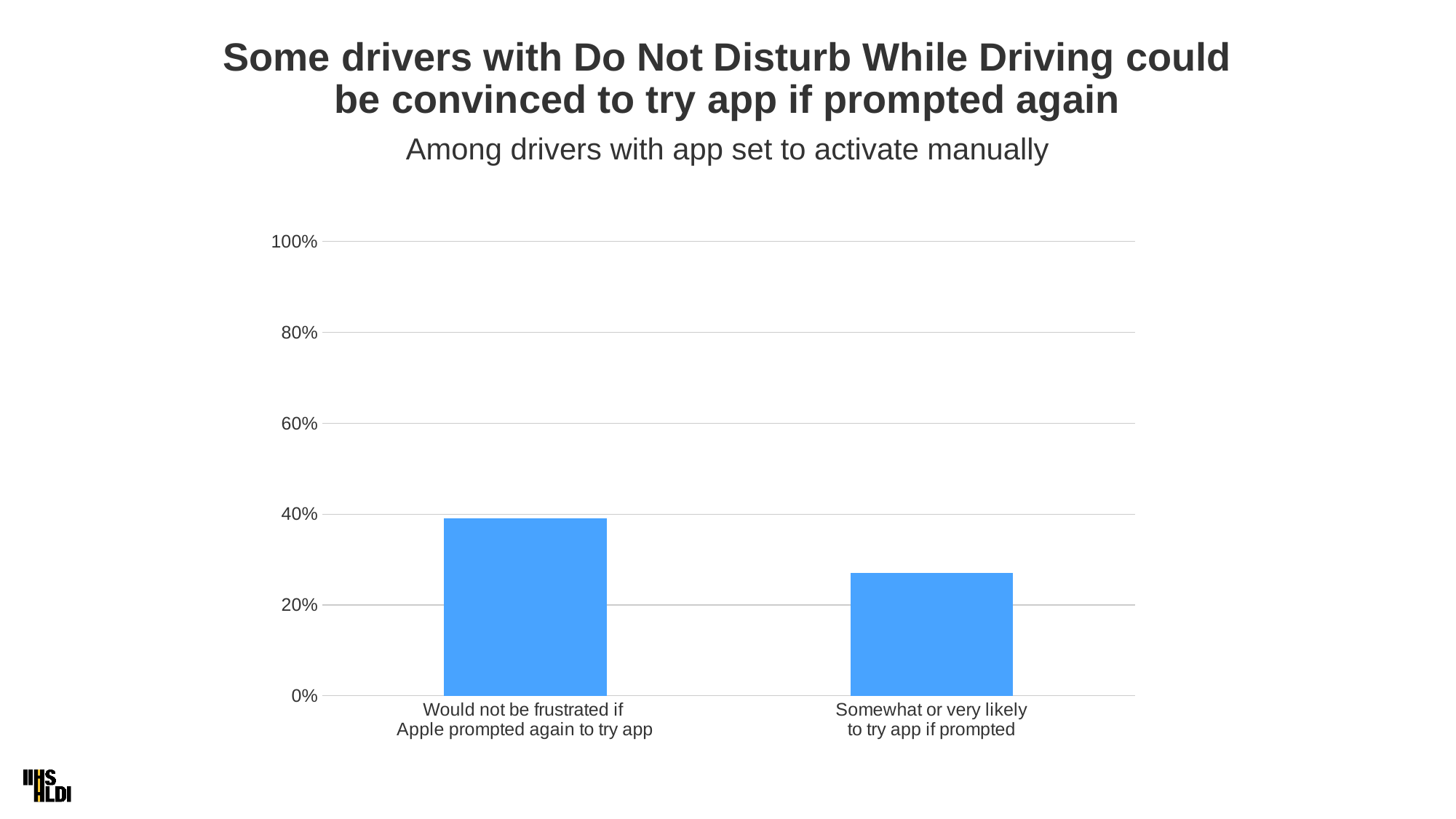
What is the highest value shown on the vertical axis? 100% Is the value for 'Would not be frustrated if Apple prompted again to try app' greater or less than 20%? greater What is the subtitle of the chart? Among drivers with app set to activate manually Which is larger: the value for 'Would not be frustrated if Apple prompted again to try app' or the value for 'Somewhat or very likely to try app if prompted'? Would not be frustrated if Apple prompted again to try app Which category has the lowest value? Somewhat or very likely to try app if prompted Is the value for 'Somewhat or very likely to try app if prompted' greater or less than 20%? greater Do the bar values rise or fall from left to right? fall Which category has the highest value? Would not be frustrated if Apple prompted again to try app What kind of chart is shown on the slide? bar chart Is the value for 'Somewhat or very likely to try app if prompted' greater or less than 40%? less How many bars does the chart show? 2